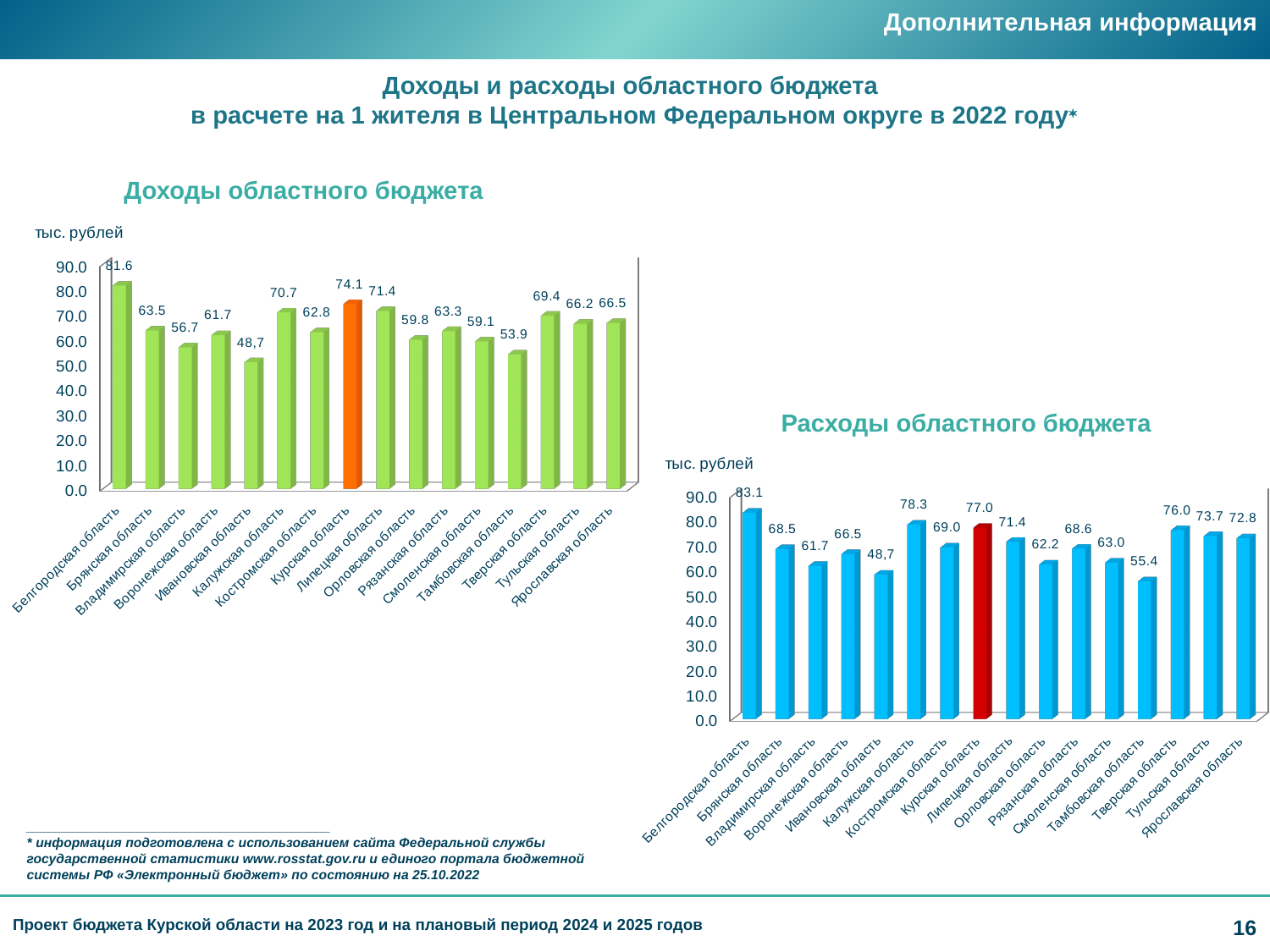
In the chart 'Доходы областного бюджета', what is the value for Курская область? 74.1 In the chart 'Доходы областного бюджета', which region has the lowest value? Ивановская область In the chart 'Расходы областного бюджета', what is the difference between the values for Белгородская область and Курская область? 6.1 In the chart 'Расходы областного бюджета', which region's bar is highlighted in red? Курская область How many regions are shown in the chart 'Доходы областного бюджета'? 16 In the chart 'Доходы областного бюджета', which is larger: the value for Тверская область or Тульская область? Тверская область In the chart 'Доходы областного бюджета', which region has the highest value? Белгородская область What type of chart is 'Расходы областного бюджета'? Bar chart In the chart 'Расходы областного бюджета', which region has the highest value? Белгородская область In the chart 'Расходы областного бюджета', what is the value for Курская область? 77.0